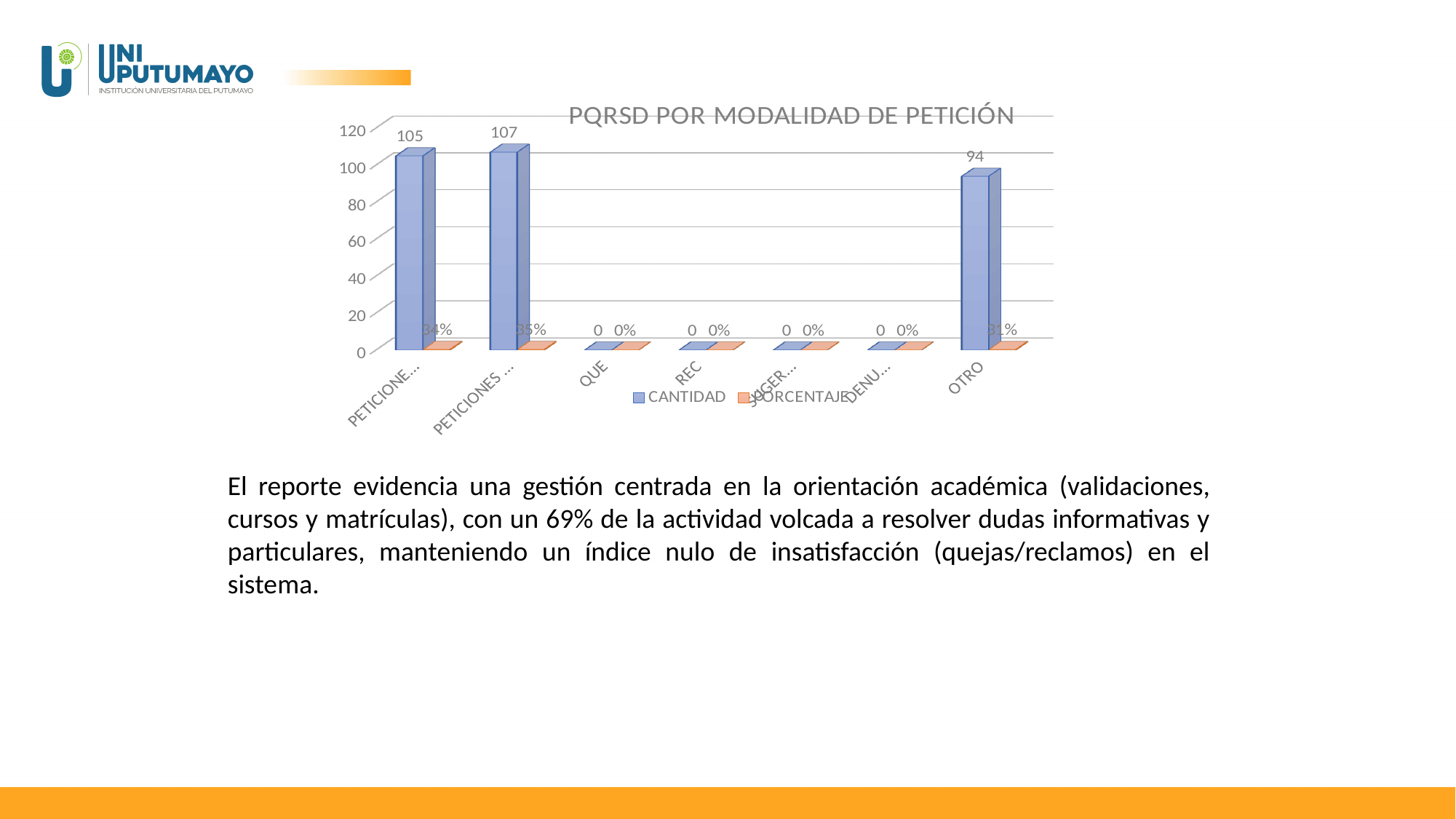
Which has a larger CANTIDAD value, OTRO or QUE? OTRO What is the difference between the highest CANTIDAD value (107) and the CANTIDAD value for OTRO? 13 How many categories are shown on the x axis? 7 What is the PORCENTAJE value for REC? 0% How many series does the chart legend list? 2 What type of chart is shown on the slide? bar chart What are the two series named in the legend? CANTIDAD and PORCENTAJE What is the title of the chart? PQRSD POR MODALIDAD DE PETICIÓN What is the PORCENTAJE value for OTRO? 31% What is the highest CANTIDAD value shown in the chart? 107 What is the CANTIDAD value for QUE? 0 What is the CANTIDAD value for OTRO? 94